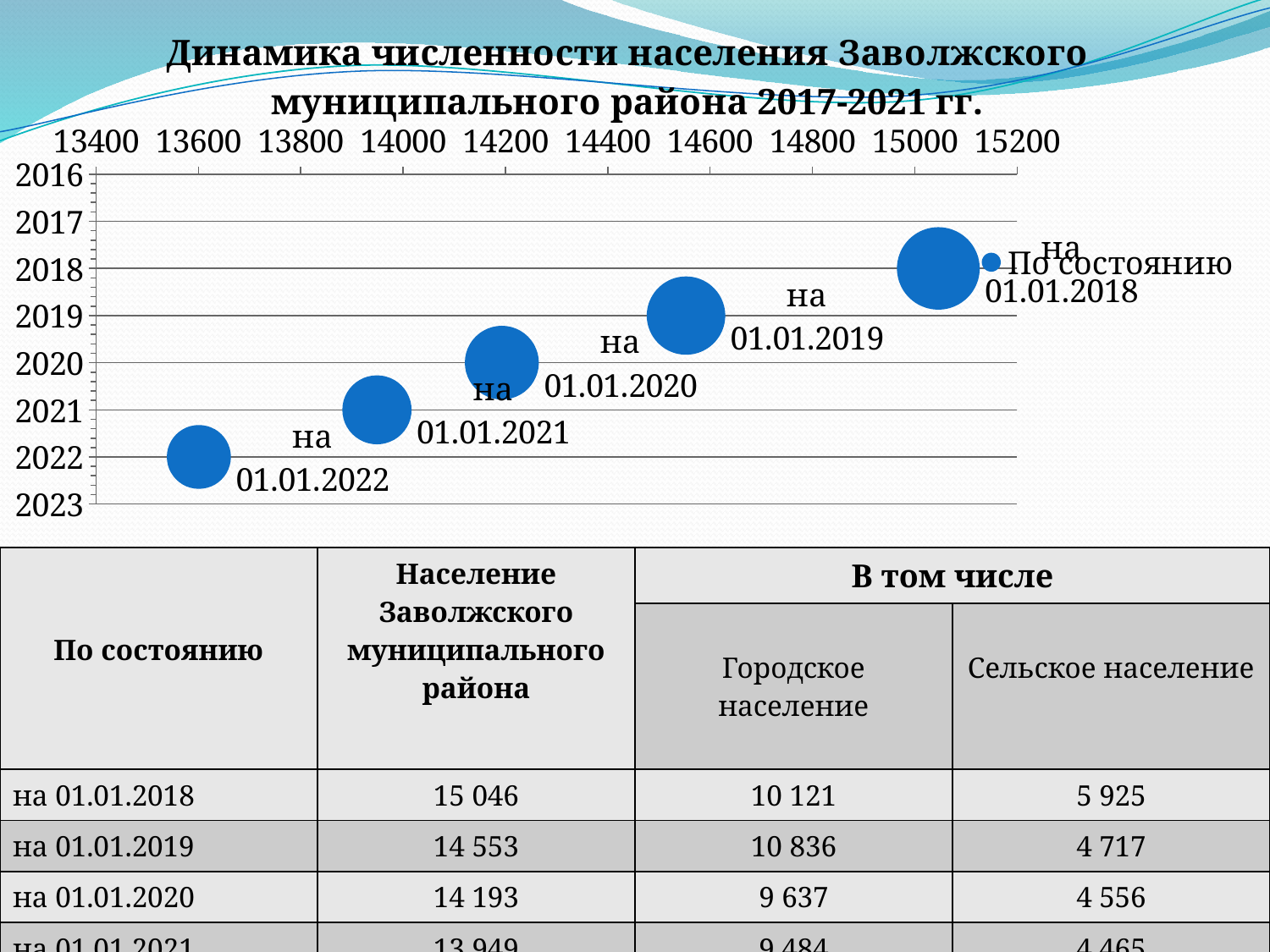
Is the value for на 01.01.2022 greater or less than 13800? less Is the value for на 01.01.2021 greater or less than 14000? less Which is larger, the value for на 01.01.2019 or the value for на 01.01.2020? на 01.01.2019 Which date has the highest population value on the chart? на 01.01.2018 What kind of chart is shown on the slide? bubble chart Is the value for на 01.01.2019 greater or less than 14600? less What is the title of the chart? Динамика численности населения Заволжского муниципального района 2017-2021 гг. Which date has the lowest population value on the chart? на 01.01.2022 Do the population values rise or fall as the dates go from 2018 to 2022? fall What is the legend entry shown on the chart? По состоянию How many data points (bubbles) are plotted on the chart? 5